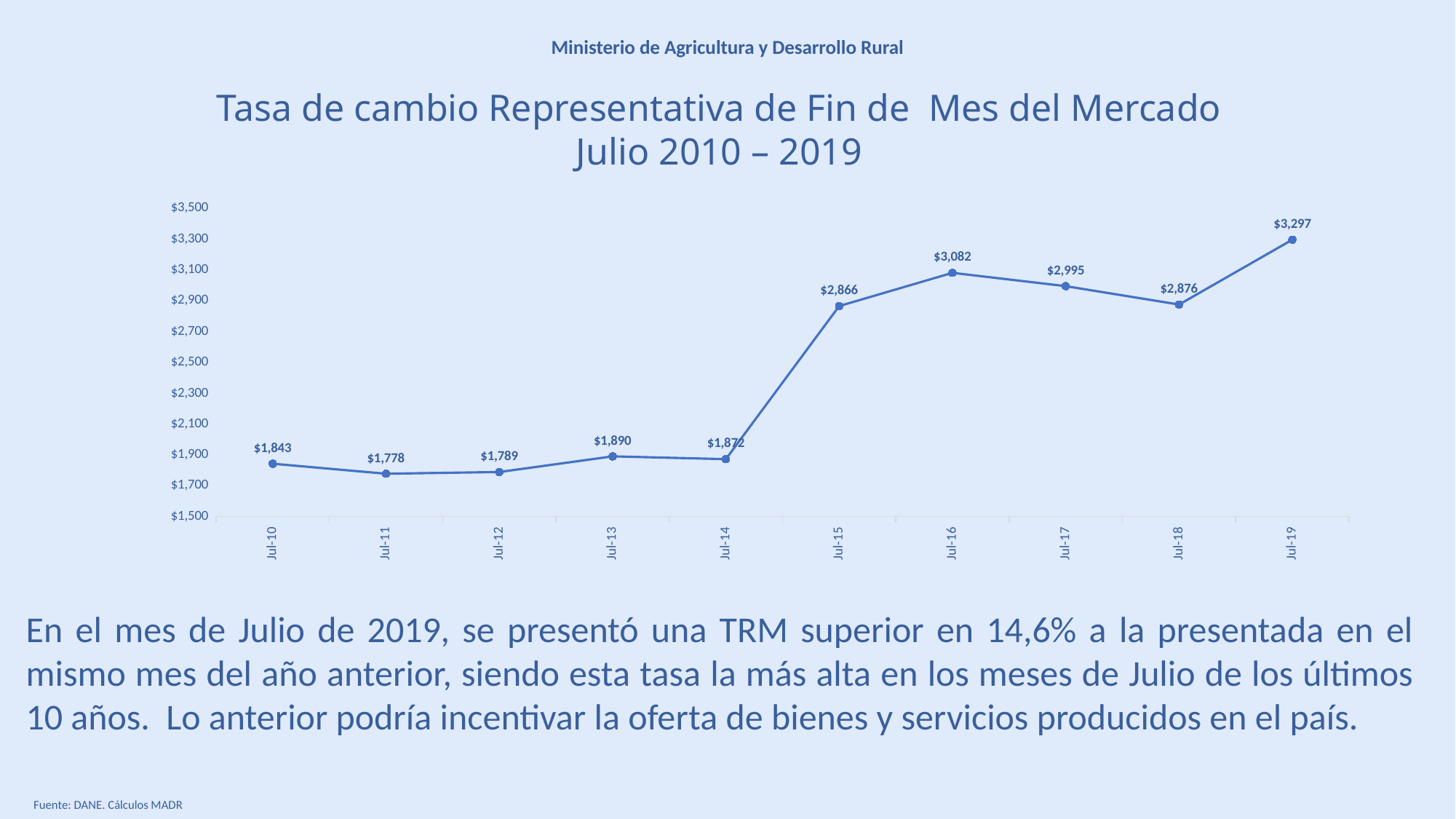
What is the difference between the values for Jul-16 and Jul-15? $216 Which point has the lowest value? Jul-11 Is the value for Jul-17 greater or less than $2,900? greater What is the value for Jul-19? $3,297 Which point has the highest value? Jul-19 How many data points are plotted on the chart? 10 Does the value rise or fall from Jul-14 to Jul-15? rise What kind of chart is shown on the slide? line chart What is the difference between the values for Jul-19 and Jul-18? $421 What is the value for Jul-15? $2,866 What is the value for Jul-11? $1,778 Which is larger, the value for Jul-13 or the value for Jul-14? Jul-13